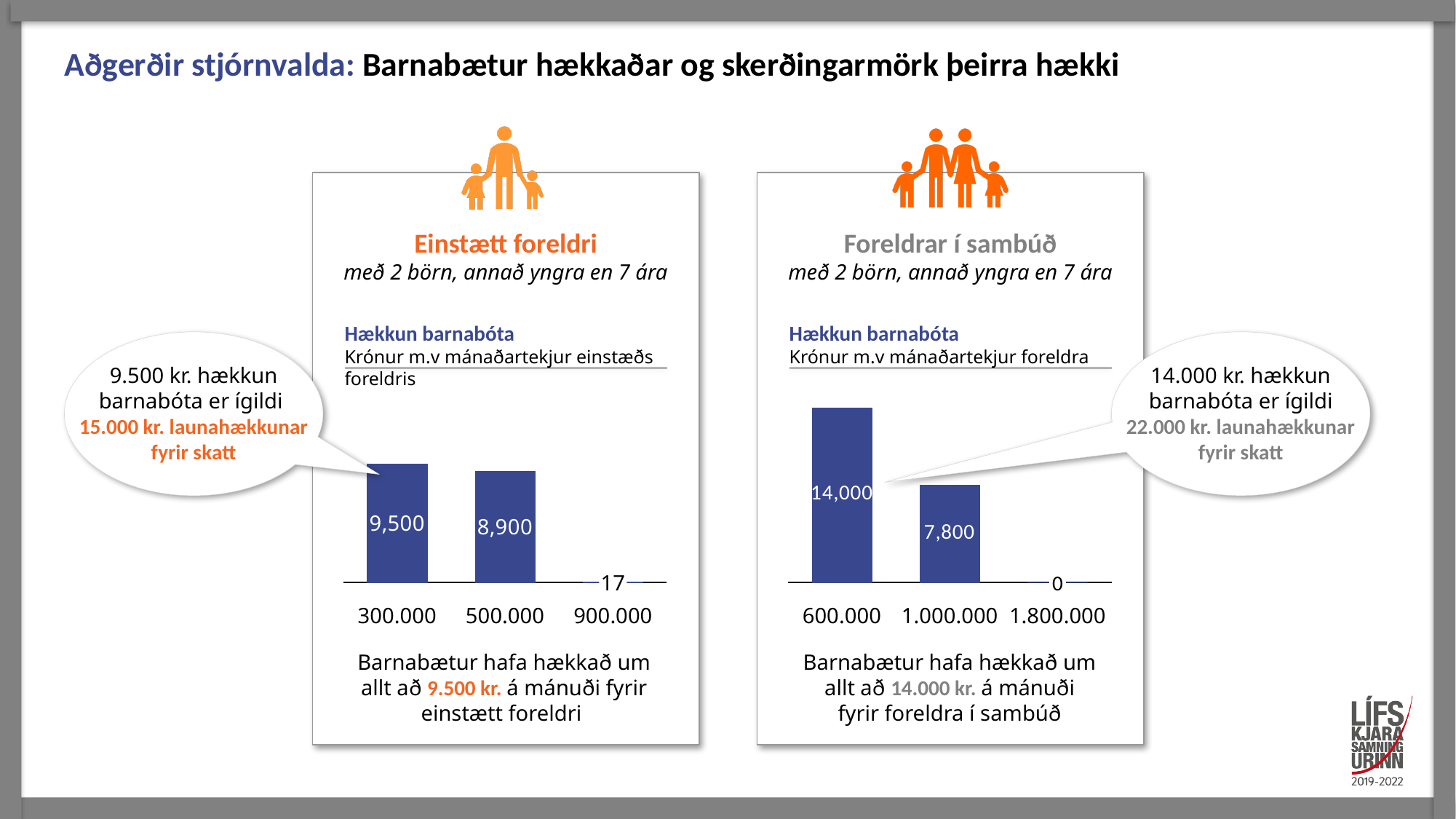
In the left chart (Einstætt foreldri), what is the value for the 900.000 income category? 17 In the right chart (Foreldrar í sambúð), what is the value for the 1.000.000 income category? 7,800 In the left chart (Einstætt foreldri), what is the value for the 300.000 income category? 9,500 How many income categories are shown on the x axis of the right chart (Foreldrar í sambúð)? 3 In the left chart (Einstætt foreldri), which income category has the lowest value? 900.000 In the right chart (Foreldrar í sambúð), which income category has the highest value? 600.000 In the left chart (Einstætt foreldri), what is the value for the 500.000 income category? 8,900 In the right chart (Foreldrar í sambúð), what is the value for the 1.800.000 income category? 0 In the left chart (Einstætt foreldri), what is the difference between the values for 300.000 and 500.000? 600 What type of chart is used in the left panel (Einstætt foreldri)? Bar chart In the right chart (Foreldrar í sambúð), what is the value for the 600.000 income category? 14,000 In the right chart (Foreldrar í sambúð), what is the difference between the values for 600.000 and 1.000.000? 6,200